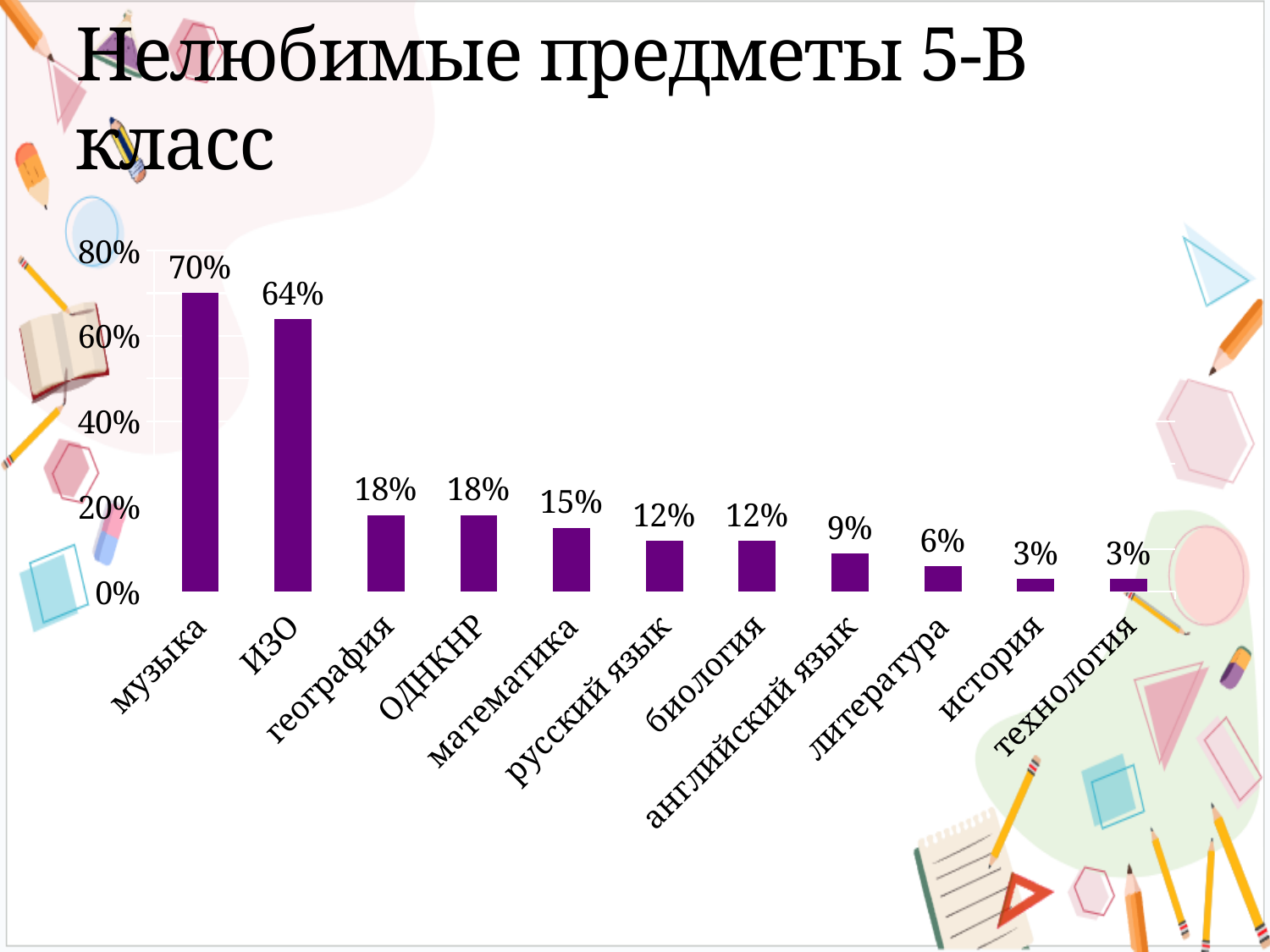
Which category has the highest value? музыка Do the values rise or fall from left to right along the x axis? fall What is the value for математика? 15% What is the difference between the values for музыка and ИЗО? 6% What kind of chart is shown on the slide? bar chart What is the value for музыка? 70% How many categories are shown on the x axis? 11 Is the value for ИЗО greater or less than 60%? greater What is the value for ИЗО? 64% What is the value for английский язык? 9% What is the title of the slide? Нелюбимые предметы 5-В класс Which is larger, the value for география or the value for литература? география